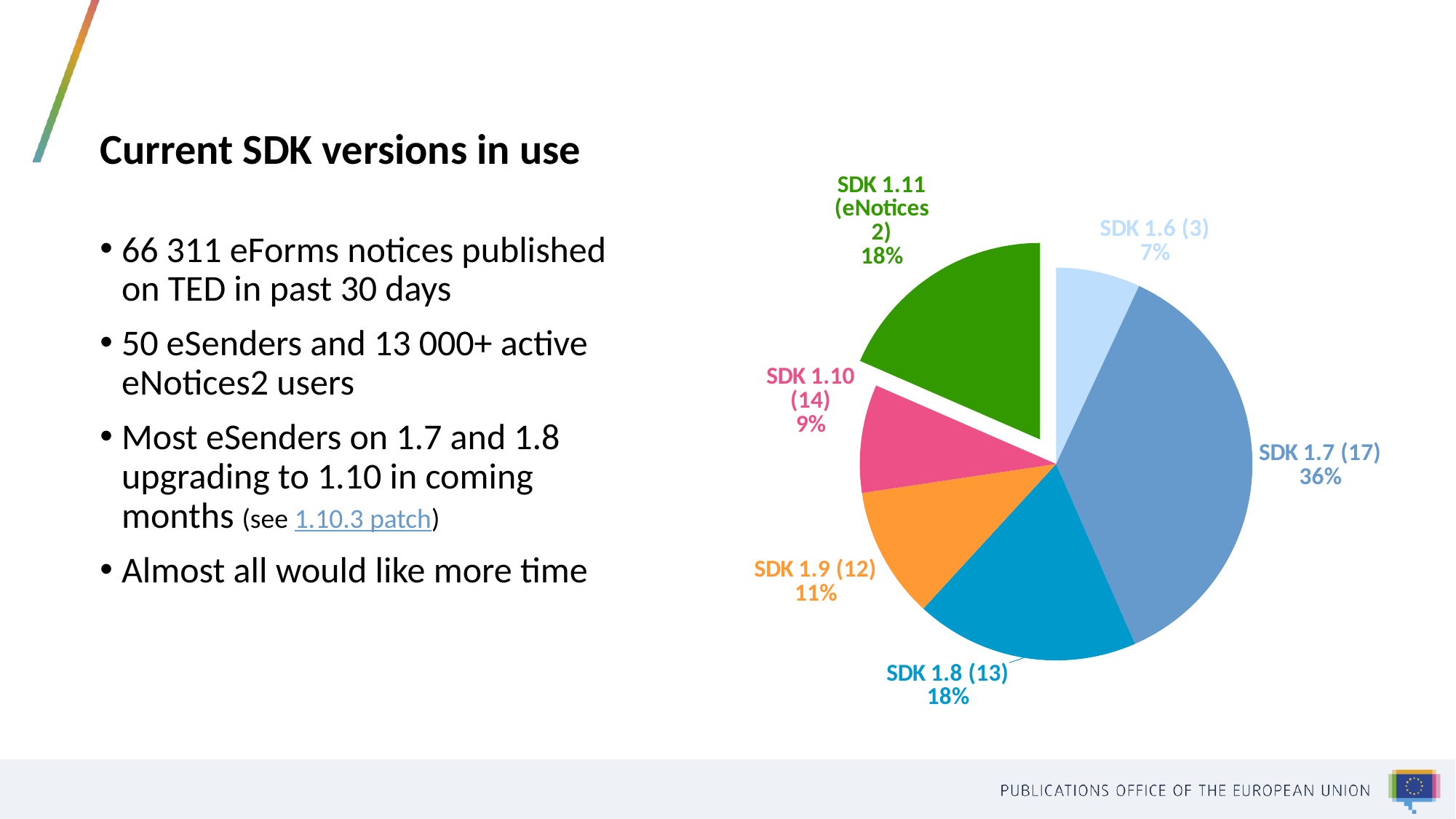
Which SDK version has the smallest slice of the pie? SDK 1.6 (3) What is the difference in percentage points between the SDK 1.7 (17) share and the SDK 1.6 (3) share? 29 Which SDK version has the largest slice of the pie? SDK 1.7 (17) What kind of chart is shown on the slide? Pie chart What percentage is shown for SDK 1.10 (14)? 9% What percentage is shown for SDK 1.9 (12)? 11% What percentage is shown for SDK 1.6 (3)? 7% Which has a larger share, SDK 1.8 (13) or SDK 1.9 (12)? SDK 1.8 (13) How many slices does the pie chart have? 6 Which slice is pulled out (exploded) from the pie? SDK 1.11 (eNotices 2) What percentage is shown for SDK 1.11 (eNotices 2)? 18% What share of the pie does SDK 1.7 (17) hold? 36%